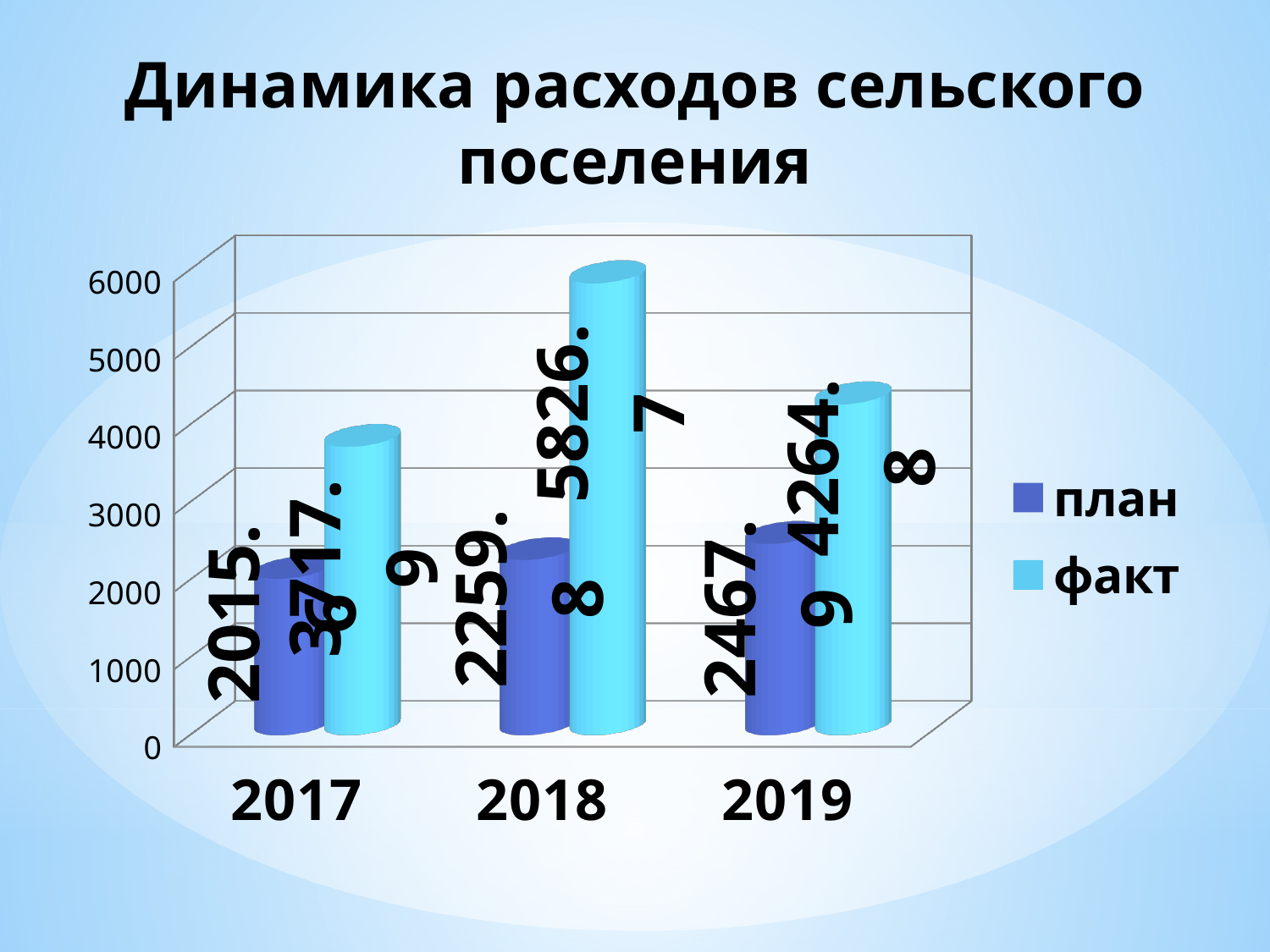
What is the value of факт for 2017? 3717.9 In which year is the факт value highest? 2018 What is the value of план for 2019? 2467.9 What is the value of план for 2018? 2259.8 What is the value of факт for 2018? 5826.7 How many years are shown on the x axis? 3 What type of chart is shown on the slide? bar chart How many series does the legend list? 2 What is the title of the chart? Динамика расходов сельского поселения In which year is the факт value lowest? 2017 What is the difference between факт and план in 2018? 3566.9 Is the план value for 2017 greater or less than 3000? less